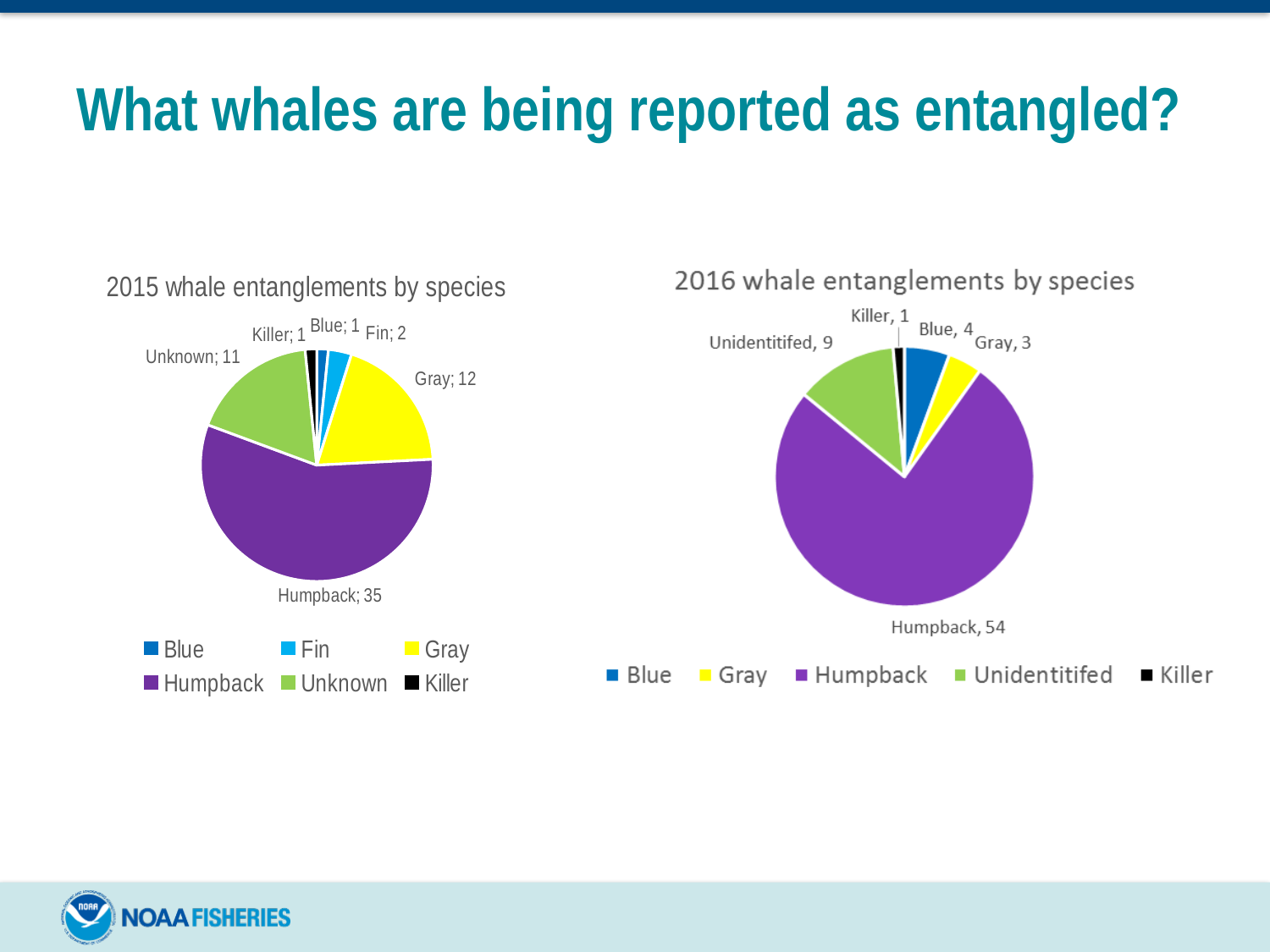
What type of chart is the '2016 whale entanglements by species' chart? Pie chart In the '2016 whale entanglements by species' chart, which is larger, the value for Blue or the value for Gray? Blue In the '2015 whale entanglements by species' chart, which species has the largest slice? Humpback In the '2015 whale entanglements by species' chart, how many entanglements are shown for Gray whales? 12 How many species categories are shown in the '2015 whale entanglements by species' chart? 6 In the '2016 whale entanglements by species' chart, which species has the smallest slice? Killer In the '2015 whale entanglements by species' chart, what is the difference between the Humpback and Unknown values? 24 In the '2016 whale entanglements by species' chart, how many entanglements are shown for Humpback whales? 54 In the '2015 whale entanglements by species' chart, what colour is the Humpback slice? Purple How many entries does the legend of the '2016 whale entanglements by species' chart list? 5 In the '2016 whale entanglements by species' chart, what is the total of all the slices? 71 In the '2015 whale entanglements by species' chart, what share of the total do Humpback whales represent, to the nearest whole percent? 56%